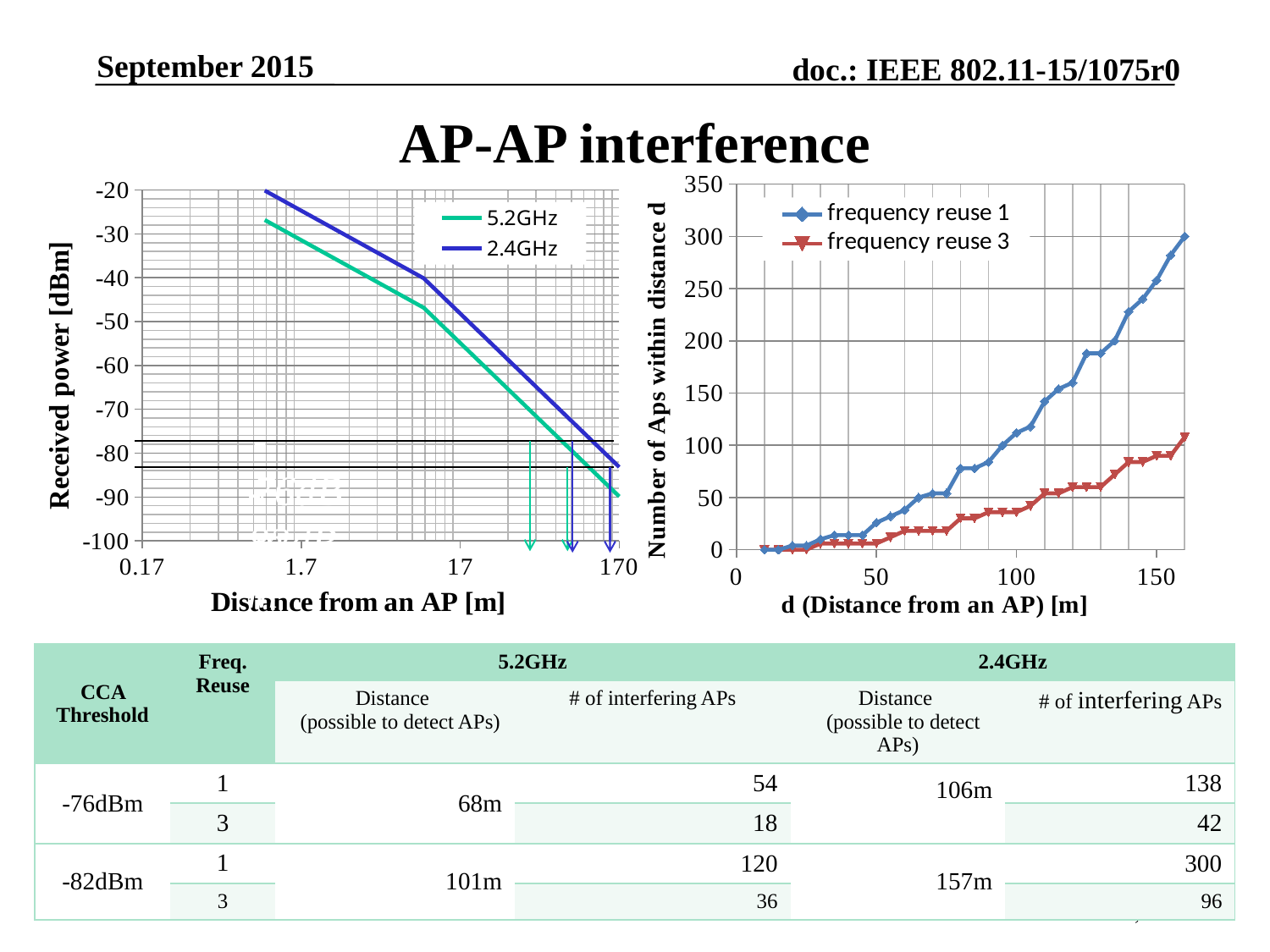
What kind of chart is the right chart showing the number of APs within distance d? line chart In the right chart (Number of APs within distance d), does the number of APs for frequency reuse 1 rise or fall as d increases? rise In the right chart (Number of APs within distance d), is the value for frequency reuse 3 at d = 150 m greater or less than 100? less How many series does the legend of the left chart (Received power vs Distance) list? 2 How many series does the legend of the right chart (Number of APs within distance d) list? 2 In the left chart (Received power vs Distance), does the received power rise or fall as the distance from the AP increases? fall What kind of chart is the left chart showing received power versus distance from an AP? line chart In the left chart (Received power vs Distance), which series has the higher received power at a distance of 17 m, 5.2GHz or 2.4GHz? 2.4GHz In the right chart (Number of APs within distance d), which series has the larger number of APs at d = 150 m, frequency reuse 1 or frequency reuse 3? frequency reuse 1 In the right chart (Number of APs within distance d), is the value for frequency reuse 1 at d = 150 m greater or less than 200? greater In the left chart (Received power vs Distance), is the received power for 5.2GHz at 170 m greater or less than -80 dBm? less What is the x-axis title of the right chart (Number of APs within distance d)? d (Distance from an AP) [m]